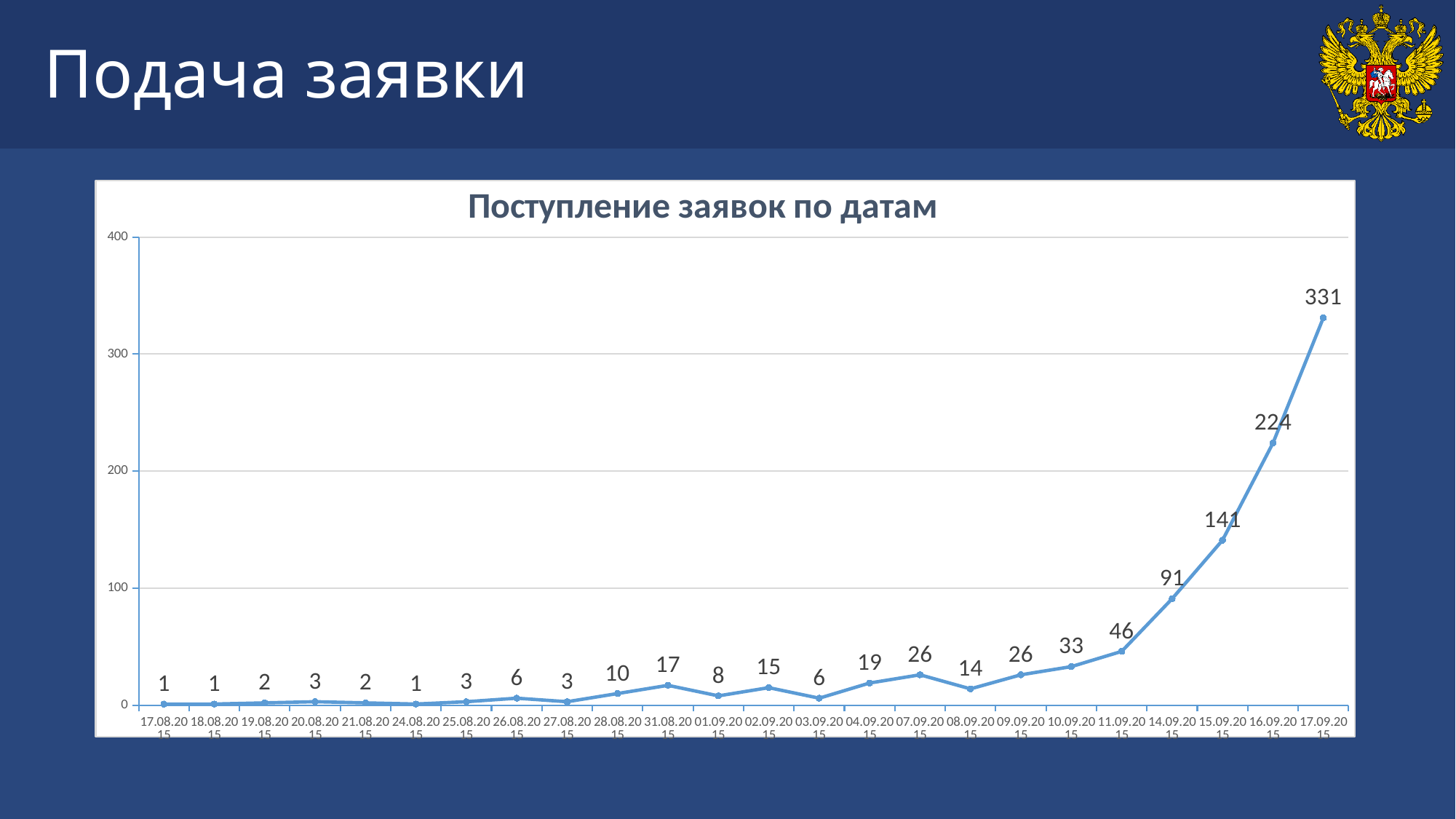
Which date has the highest value? 17.09.2015 What is the difference between the values for 17.09.2015 and 16.09.2015? 107 Do the values generally rise or fall from 10.09.2015 to 17.09.2015? rise What is the value for 14.09.2015? 91 How many dates are plotted on the chart? 24 What is the value for 17.09.2015? 331 What kind of chart is shown? line chart What is the title of the chart? Поступление заявок по датам Which is larger, the value for 07.09.2015 or the value for 08.09.2015? 07.09.2015 Is the value for 16.09.2015 greater or less than 200? greater What is the value for 31.08.2015? 17 What is the difference between the values for 15.09.2015 and 14.09.2015? 50